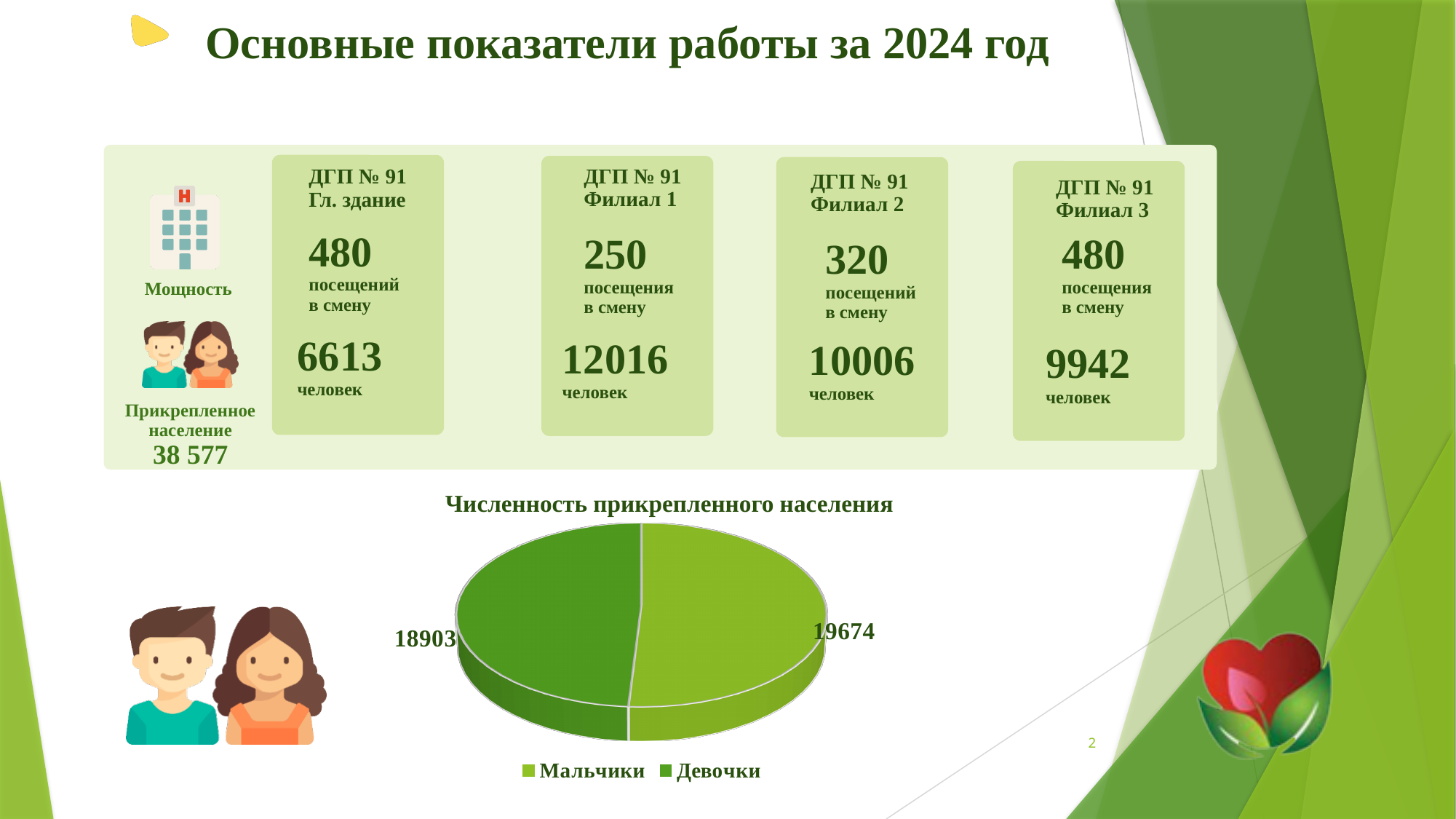
Which category has the largest slice in the pie chart? Мальчики What kind of chart is shown under the title "Численность прикрепленного населения"? pie chart Which category has the smallest slice in the pie chart? Девочки What is the value for Мальчики in the pie chart? 19674 How many entries does the legend of the pie chart list? 2 What share of the pie chart does Мальчики represent, to the nearest whole percent? 51% Which is larger in the pie chart, Мальчики or Девочки? Мальчики What is the value for Девочки in the pie chart? 18903 What is the title of the pie chart? Численность прикрепленного населения What is the difference between the values for Мальчики and Девочки in the pie chart? 771 What is the total of the two values shown in the pie chart? 38577 How many slices does the pie chart have? 2